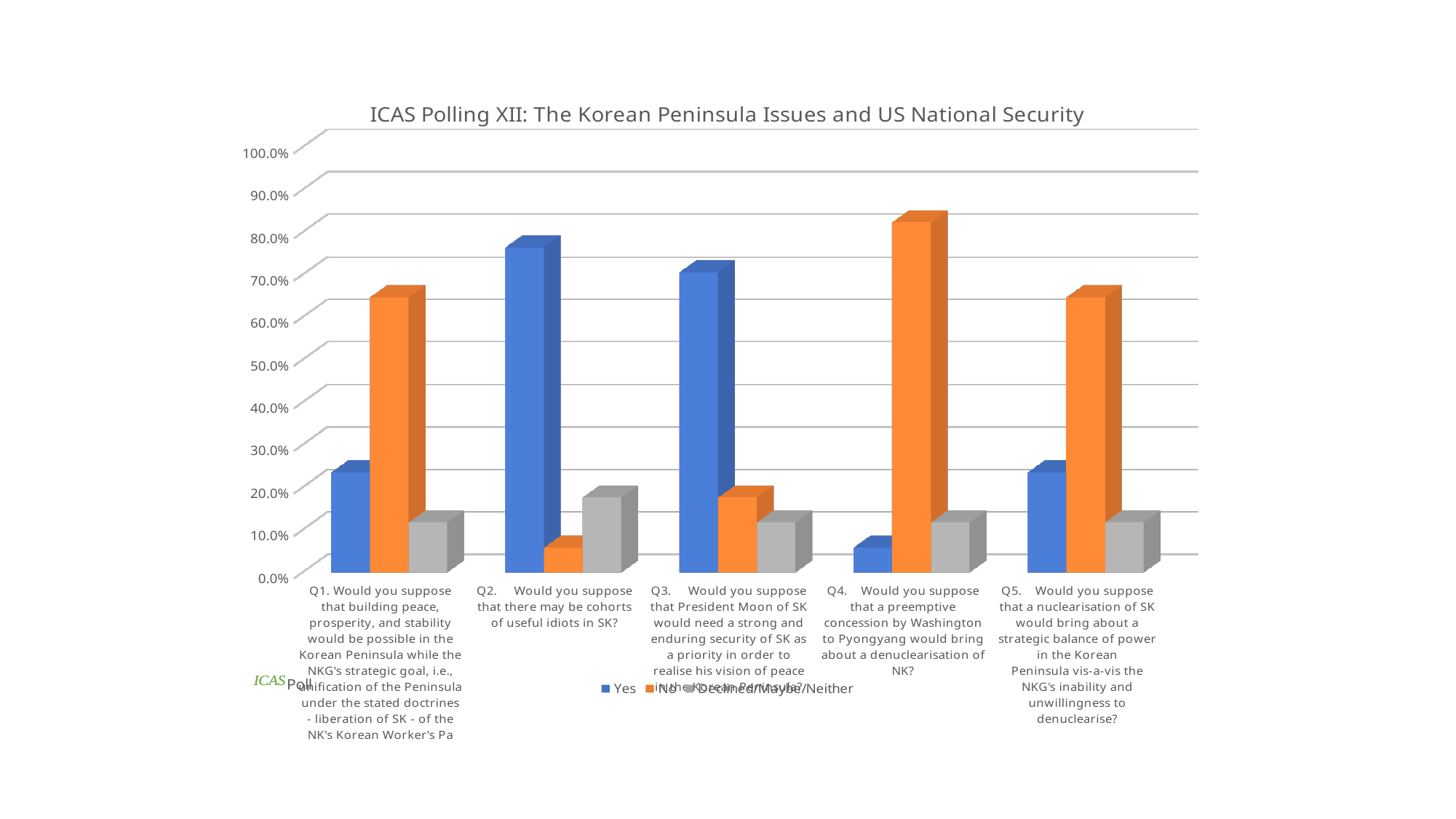
How many questions (categories) are plotted along the x axis? 5 What kind of chart is shown on the slide? bar chart Which question has the highest 'Yes' value? Q2 Is the 'Yes' value for Q4 greater or less than 20.0%? less How many series does the legend list? 3 Is the 'No' value for Q4 greater or less than 70.0%? greater Which question has the highest 'No' value? Q4 For Q3, which is larger, the 'Yes' value or the 'Declined/Maybe/Neither' value? Yes For Q1, which is larger, the 'Yes' value or the 'No' value? No Which question has the lowest 'No' value? Q2 Which question has the highest 'Declined/Maybe/Neither' value? Q2 Which question has the lowest 'Yes' value? Q4